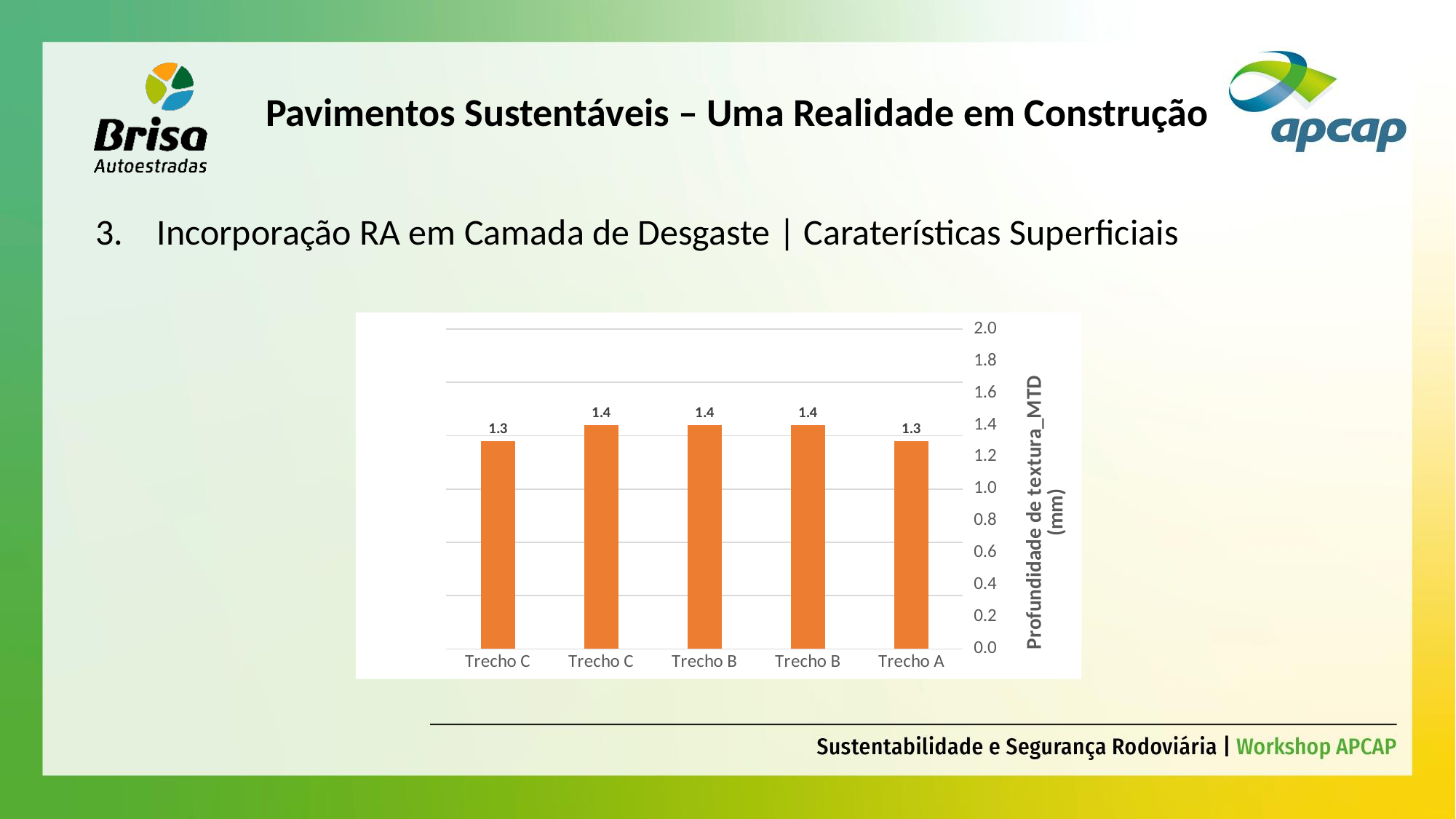
What is the lowest value shown in the chart? 1.3 What kind of chart is shown on the slide? bar chart How many bars are plotted in the chart? 5 Is the value for Trecho A greater or less than 1.0? greater What is the value of the second bar from the left (Trecho C)? 1.4 What is the label of the vertical axis? Profundidade de textura_MTD (mm) What is the difference between the value for Trecho B and the value for Trecho A? 0.1 How many bars have a value of 1.4? 3 Which is larger, the value for Trecho B or the value for Trecho A? Trecho B What is the highest value shown in the chart? 1.4 What is the value of the leftmost bar (Trecho C)? 1.3 What is the value for Trecho A? 1.3